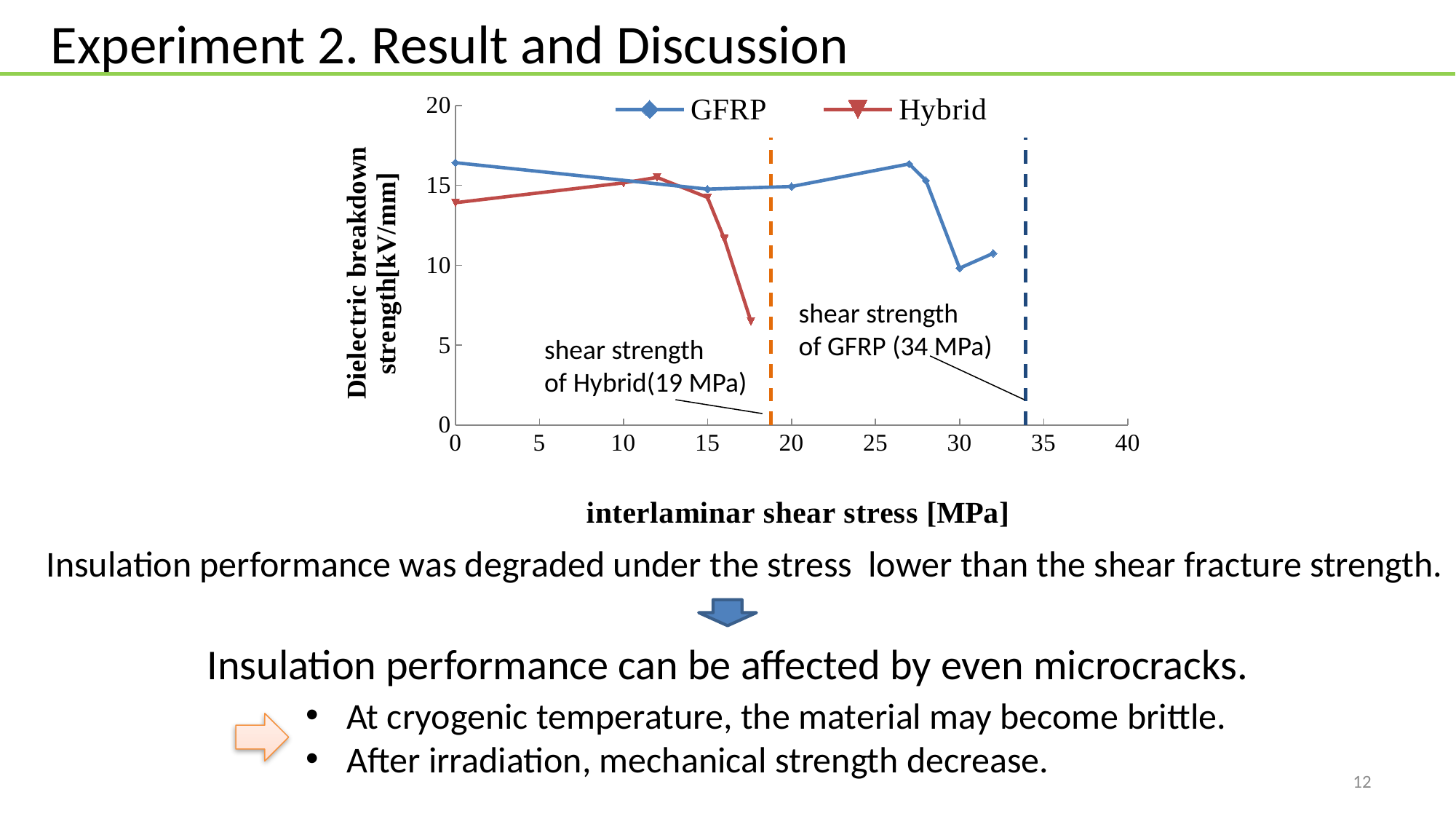
At 0 MPa shear stress, which series has the higher dielectric breakdown strength, GFRP or Hybrid? GFRP According to the annotation on the chart, what is the shear strength of Hybrid? 19 MPa What are the two series named in the chart legend? GFRP and Hybrid Is the dielectric breakdown strength of Hybrid at 0 MPa shear stress greater or less than 15 kV/mm? less According to the annotation on the chart, what is the shear strength of GFRP? 34 MPa Is the last plotted value of the Hybrid series greater or less than 10 kV/mm? less Is the dielectric breakdown strength of GFRP at 0 MPa shear stress greater or less than 15 kV/mm? greater Which series reaches the lowest dielectric breakdown strength on the chart, GFRP or Hybrid? Hybrid What kind of chart is shown on the slide? Line chart Does the Hybrid series rise or fall as the shear stress increases beyond about 12 MPa? fall What is the label of the x axis of the chart? interlaminar shear stress [MPa] How many series does the chart legend list? 2